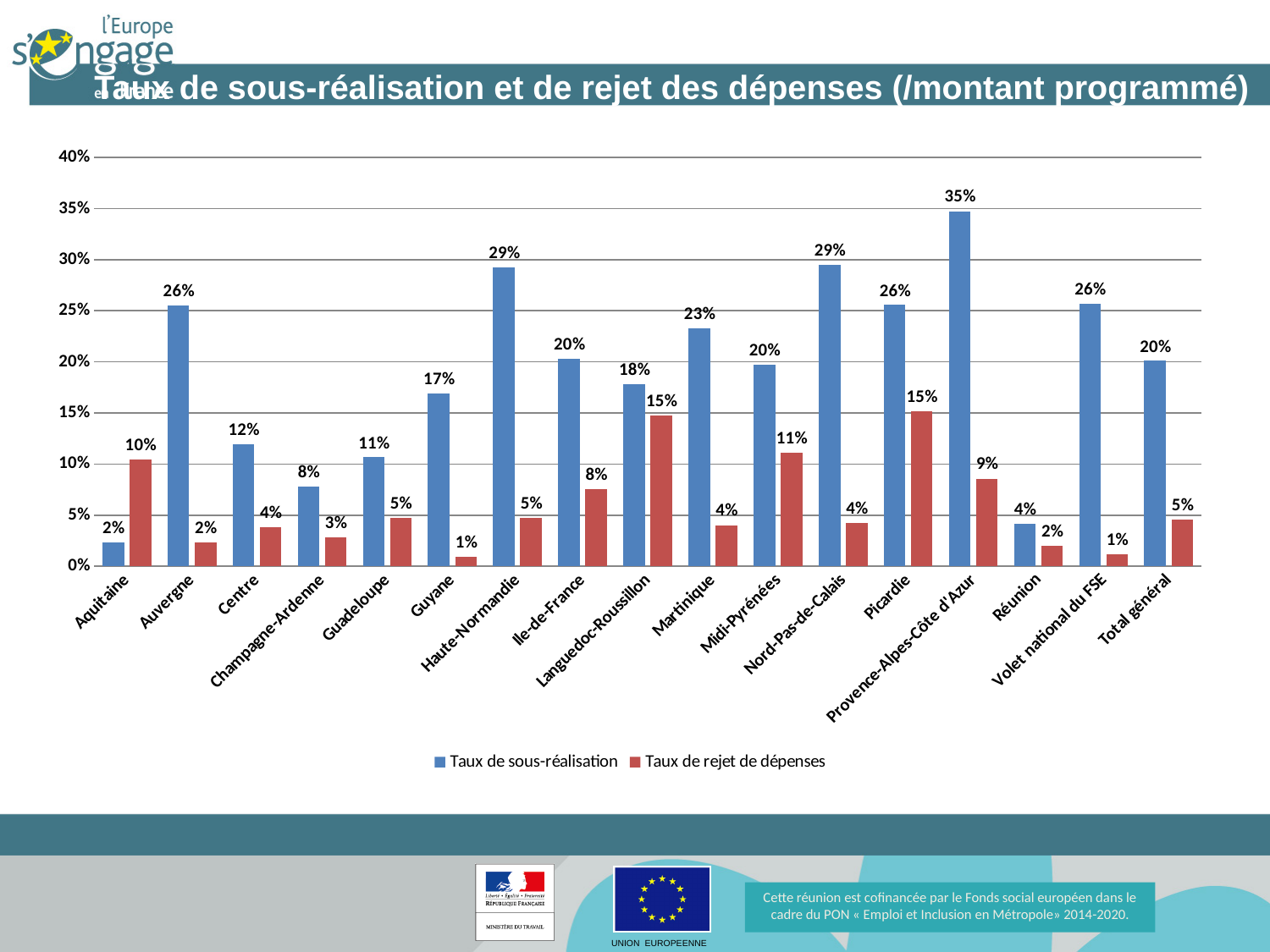
How many series does the legend list? 2 For Aquitaine, which is larger: the Taux de sous-réalisation or the Taux de rejet de dépenses? Taux de rejet de dépenses How many categories are shown on the x axis? 17 Which region has the highest Taux de sous-réalisation? Provence-Alpes-Côte d'Azur What is the difference between the Taux de sous-réalisation and the Taux de rejet de dépenses for Picardie? 11 percentage points Is the Taux de sous-réalisation for Provence-Alpes-Côte d'Azur greater or less than 30%? greater What is the Taux de sous-réalisation for Haute-Normandie? 29% Which category has the lowest Taux de sous-réalisation? Aquitaine What is the Taux de sous-réalisation for Total général? 20% What is the Taux de rejet de dépenses for Aquitaine? 10% What kind of chart is shown on the slide? Bar chart What is the Taux de rejet de dépenses for Midi-Pyrénées? 11%